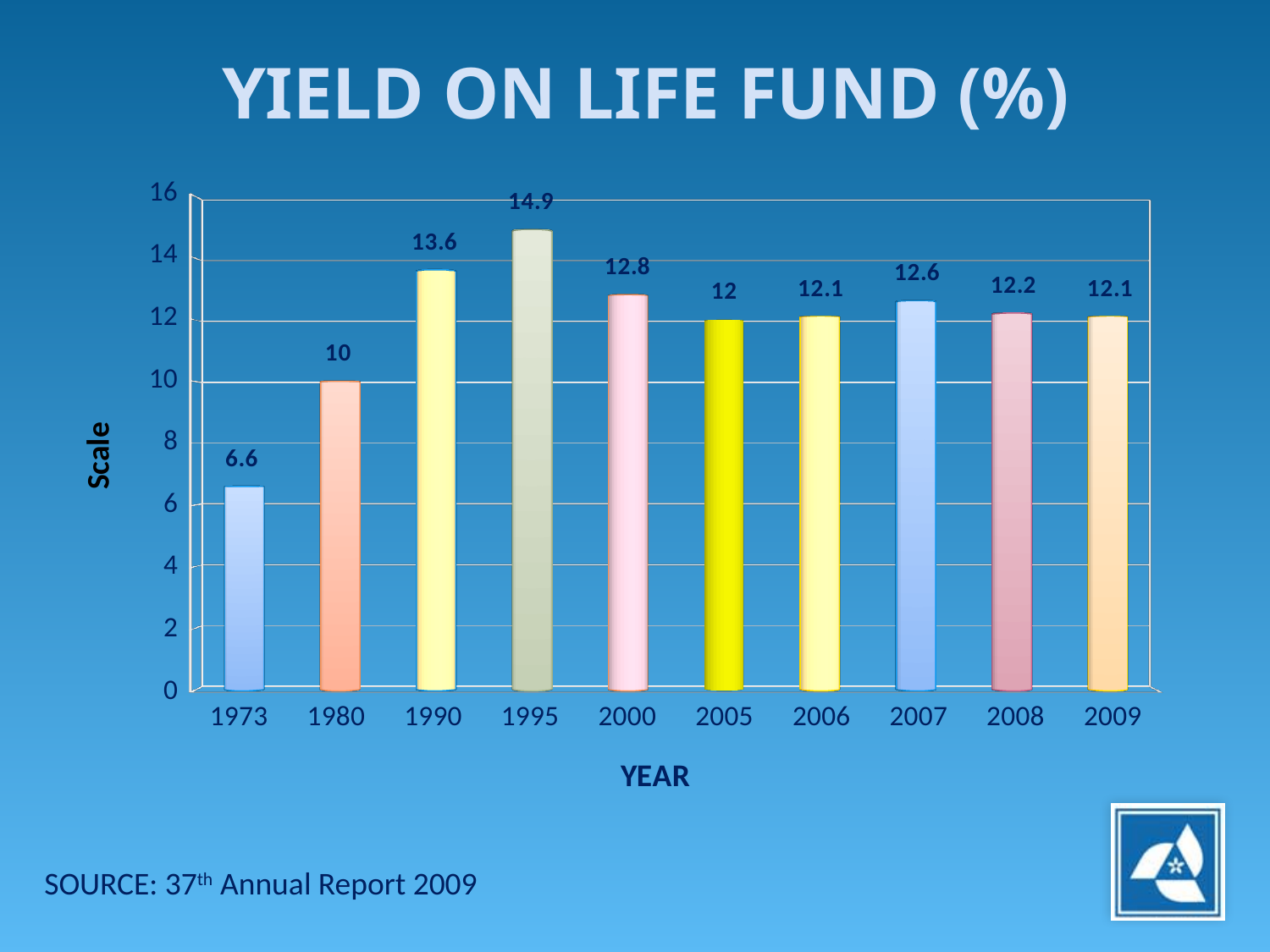
Which year has the lowest yield on life fund? 1973 What is the yield on life fund for 1973? 6.6 What is the yield on life fund for 2007? 12.6 What is the difference between the yield in 1980 and the yield in 1973? 3.4 Is the value for 1980 greater or less than 12? less What is the title of the chart? YIELD ON LIFE FUND (%) Which year has a higher yield, 2000 or 2005? 2000 Which year has the highest yield on life fund? 1995 What kind of chart is shown on the slide? Bar chart What is the difference between the yield in 1995 and the yield in 1990? 1.3 How many years are shown on the x axis? 10 What is the yield on life fund for 1995? 14.9